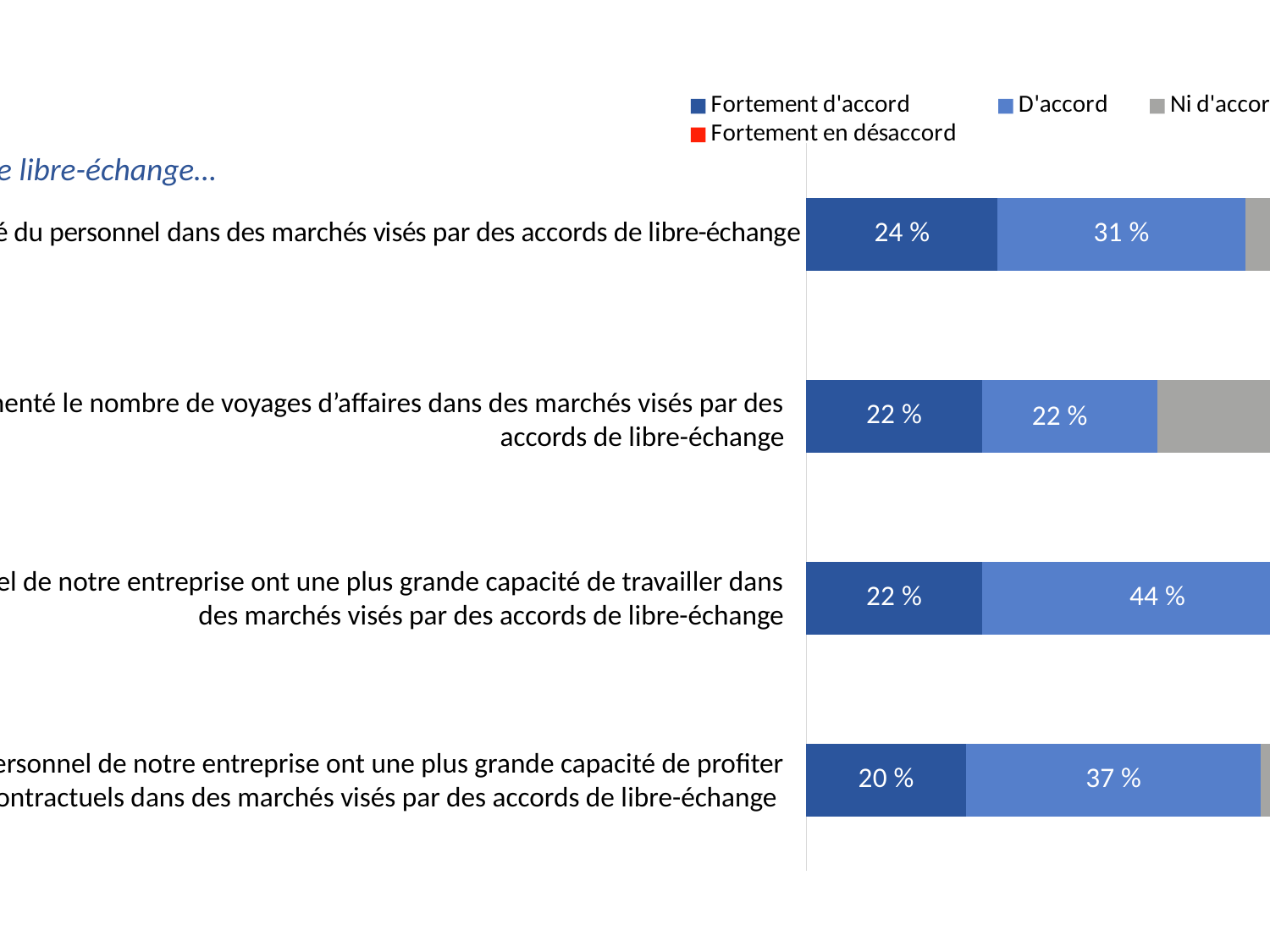
What is the 'D'accord' value for the bar about 'le nombre de voyages d'affaires dans des marchés visés par des accords de libre-échange'? 22 % What colour represents 'Fortement en désaccord' in the legend? red In the third bar from the top, how much larger is the 'D'accord' value than the 'Fortement d'accord' value? 22 % What is the 'Fortement d'accord' value for the top bar (the statement ending 'du personnel dans des marchés visés par des accords de libre-échange')? 24 % How many bars (statements) does the chart show? 4 What is the 'Fortement d'accord' value for the bottom bar (the statement about 'une plus grande capacité de profiter')? 20 % What is the 'D'accord' value for the third bar from the top (the statement about 'une plus grande capacité de travailler')? 44 % What is the first entry listed in the legend? Fortement d'accord Which bar has the highest 'D'accord' value? the third bar from the top (capacité de travailler), 44 % Which is larger: the 'D'accord' value of the top bar or the 'D'accord' value of the bottom bar? the bottom bar (37 %) What kind of chart is shown on the slide? bar chart Which bar has the lowest 'Fortement d'accord' value? the bottom bar (capacité de profiter), 20 %